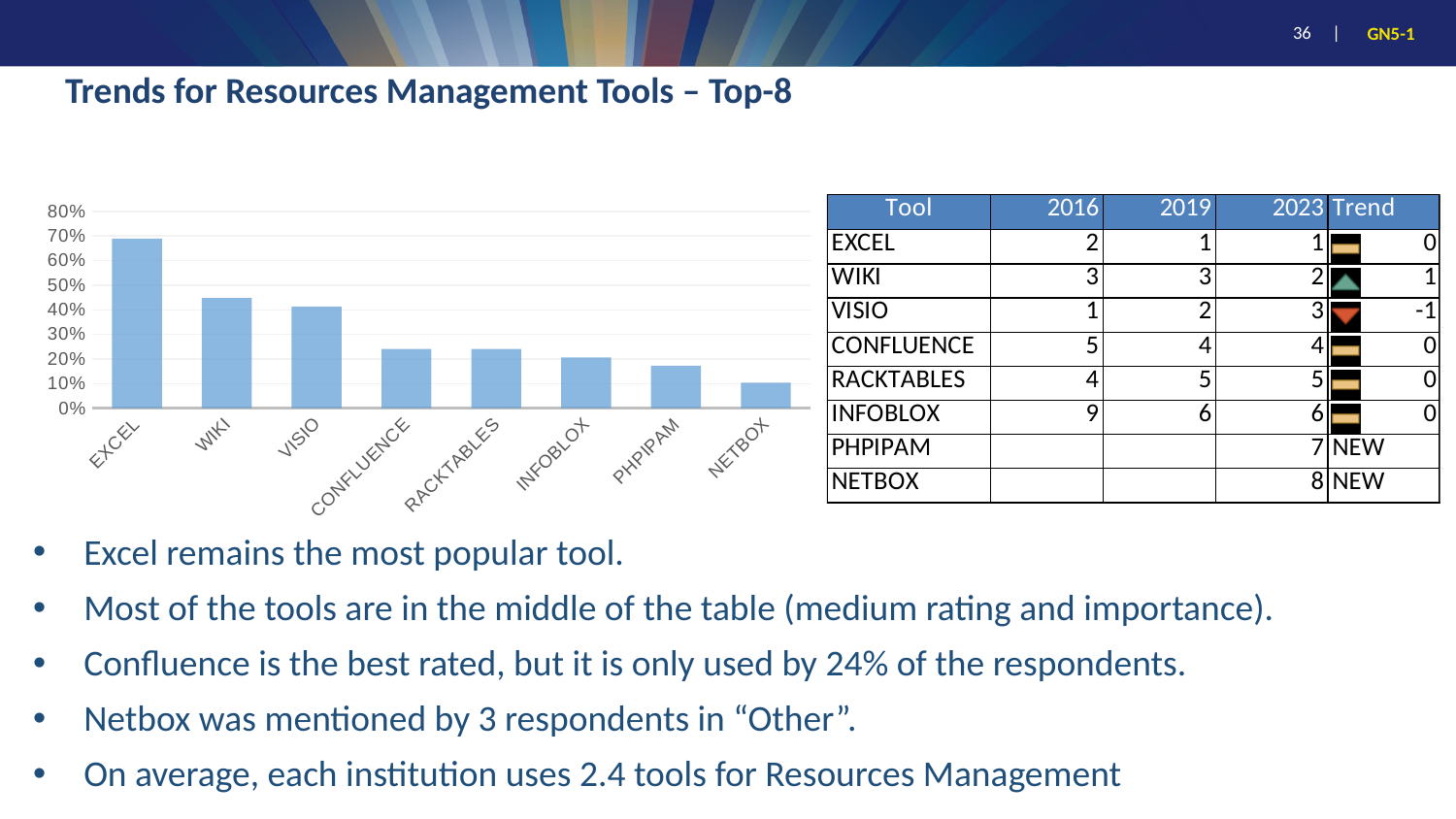
What is the title of the slide containing the chart? Trends for Resources Management Tools – Top-8 Which tool has the highest bar in the chart? EXCEL How many tools are shown as bars in the chart? 8 Which tool has the lowest bar in the chart? NETBOX Do the bar values generally rise or fall from left to right across the chart? fall Which has a larger value in the chart, WIKI or PHPIPAM? WIKI Is the value for NETBOX greater or less than 20%? less Is the value for EXCEL greater or less than 60%? greater Is the value for INFOBLOX greater or less than 30%? less What kind of chart is shown on the slide? bar chart